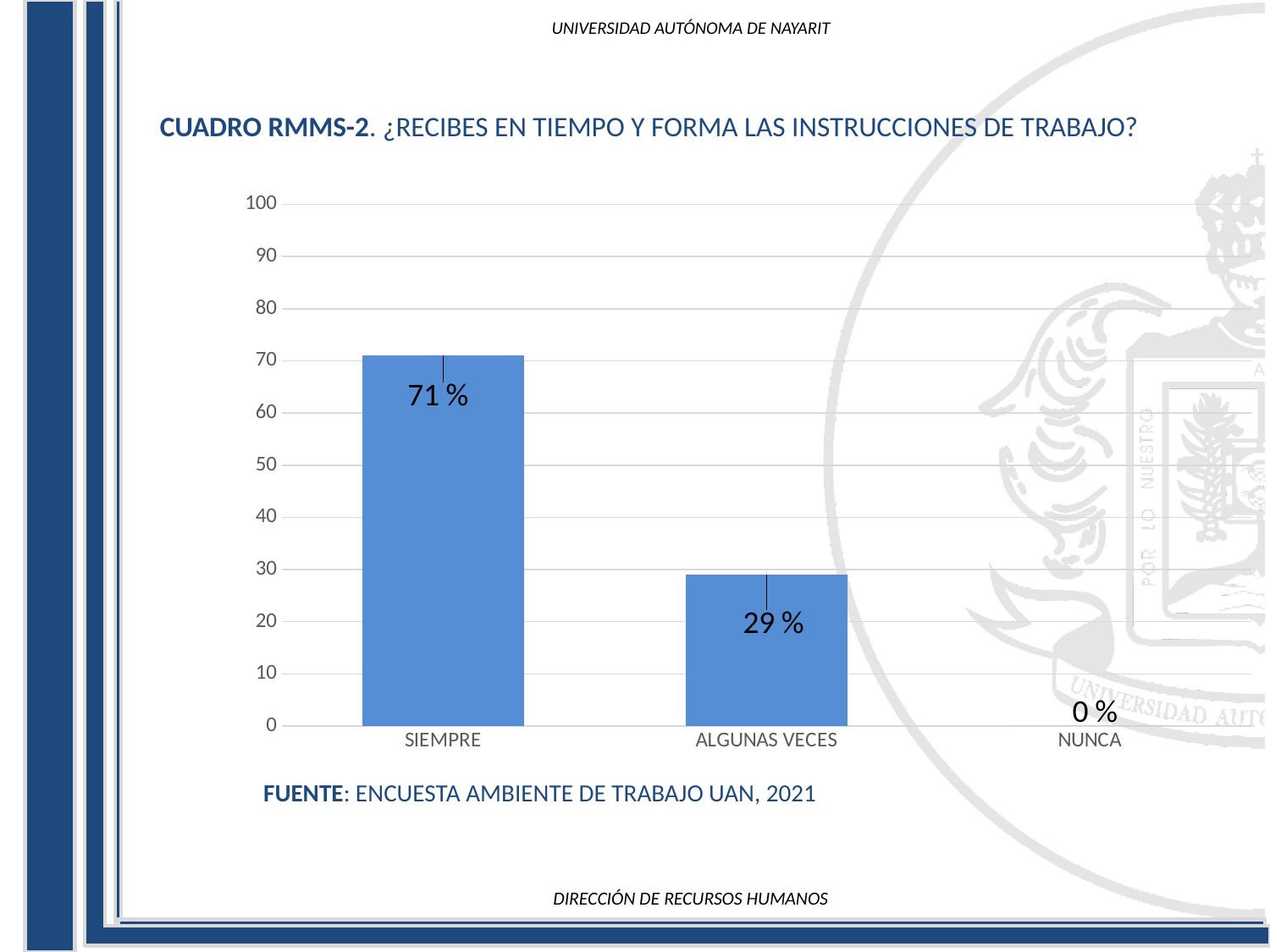
What is the value for ALGUNAS VECES? 29 % Which is larger, the value for SIEMPRE or the value for ALGUNAS VECES? SIEMPRE What is the source cited below the chart? ENCUESTA AMBIENTE DE TRABAJO UAN, 2021 Which category has the highest value? SIEMPRE What is the difference between the values for SIEMPRE and ALGUNAS VECES? 42 % What kind of chart is shown on the slide? bar chart How many categories are shown on the x axis? 3 What is the value for NUNCA? 0 % Is the value for ALGUNAS VECES greater or less than 40? less What is the value for SIEMPRE? 71 % Which category has the lowest value? NUNCA Is the value for SIEMPRE greater or less than 60? greater